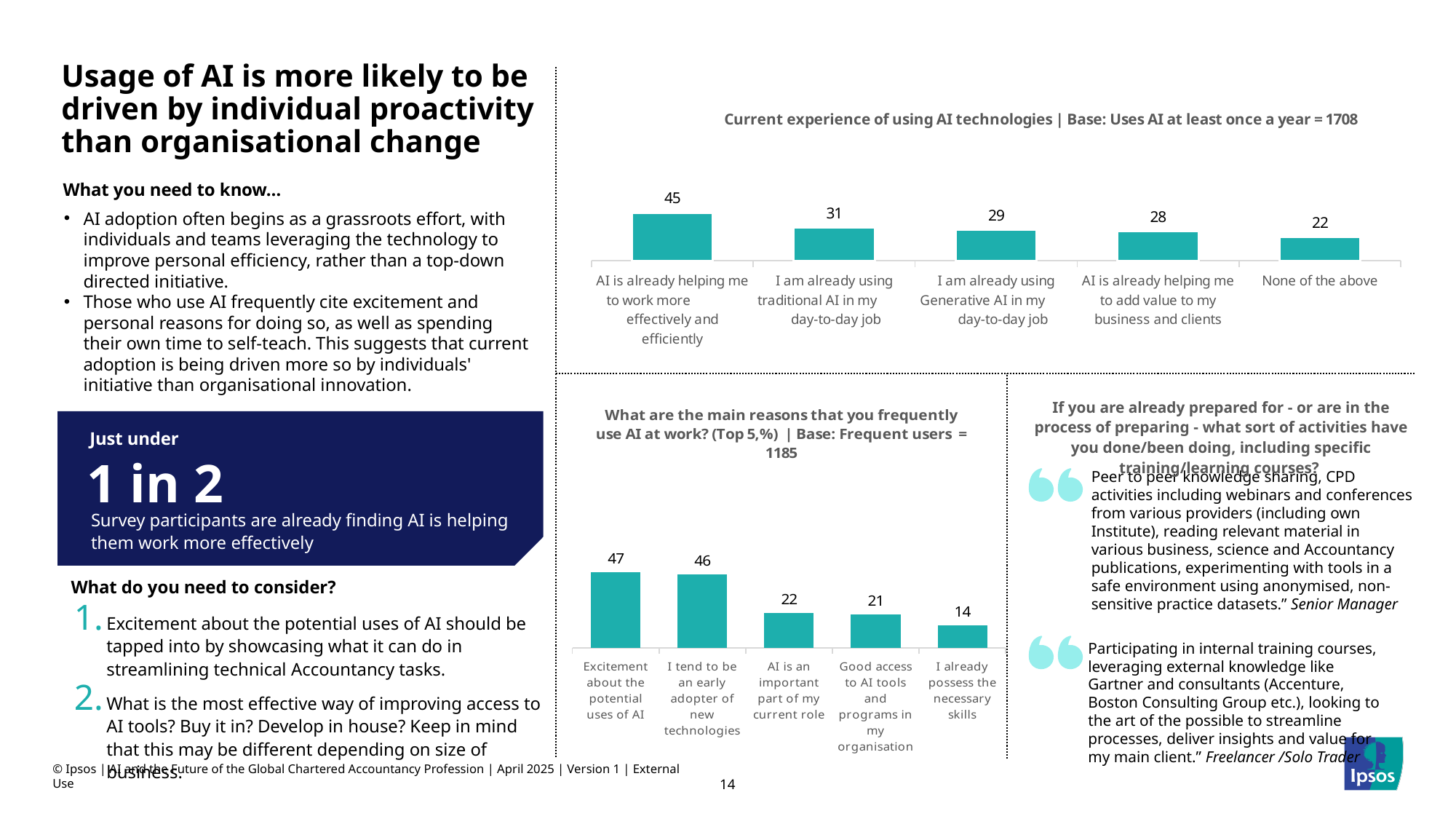
In the top chart on current experience of using AI technologies, what is the difference between "I am already using traditional AI in my day-to-day job" and "I am already using Generative AI in my day-to-day job"? 2 In the top chart on current experience of using AI technologies, which category has the highest value? AI is already helping me to work more effectively and efficiently In the bottom chart on the main reasons for frequently using AI at work, which is larger: "I tend to be an early adopter of new technologies" or "Good access to AI tools and programs in my organisation"? I tend to be an early adopter of new technologies In the top chart on current experience of using AI technologies, what is the value for "None of the above"? 22 In the bottom chart on the main reasons for frequently using AI at work, what is the value for "I already possess the necessary skills"? 14 In the bottom chart on the main reasons for frequently using AI at work, what is the value for "Excitement about the potential uses of AI"? 47 How many categories are shown in the top chart on current experience of using AI technologies? 5 In the bottom chart on the main reasons for frequently using AI at work, what is the difference between "Excitement about the potential uses of AI" and "AI is an important part of my current role"? 25 What type of chart is the top chart on current experience of using AI technologies? Bar chart What is the base size stated in the title of the bottom chart on the main reasons for frequently using AI at work? 1185 In the bottom chart on the main reasons for frequently using AI at work, which category has the lowest value? I already possess the necessary skills In the top chart on current experience of using AI technologies, what is the value for "AI is already helping me to work more effectively and efficiently"? 45